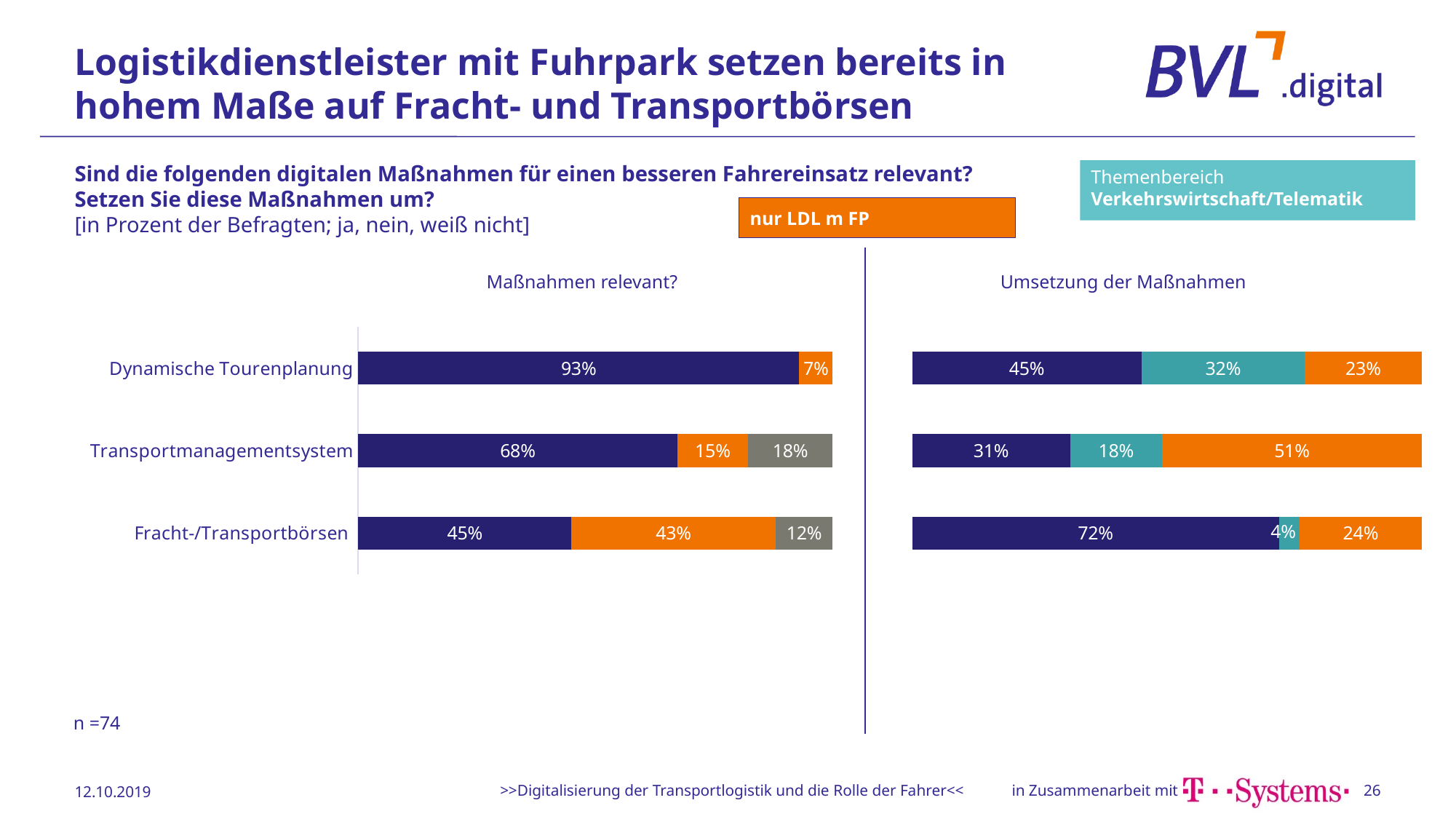
In the 'Maßnahmen relevant?' chart, which category has the highest value in the first (dark blue) segment? Dynamische Tourenplanung What type of chart is the 'Maßnahmen relevant?' chart? Stacked bar chart In the 'Umsetzung der Maßnahmen' chart, what is the total of the three segments for Dynamische Tourenplanung? 100% In the 'Umsetzung der Maßnahmen' chart, what is the difference between the orange segment for Transportmanagementsystem and the orange segment for Dynamische Tourenplanung? 28% In the 'Umsetzung der Maßnahmen' chart, what is the value of the teal segment for Transportmanagementsystem? 18% What is the sample size (n) stated on the slide? n =74 How many categories are shown in the 'Umsetzung der Maßnahmen' chart? 3 In the 'Maßnahmen relevant?' chart, what is the value of the first (dark blue) segment for Dynamische Tourenplanung? 93% In the 'Umsetzung der Maßnahmen' chart, what is the value of the first (dark blue) segment for Fracht-/Transportbörsen? 72% In the 'Maßnahmen relevant?' chart, which is larger: the grey segment for Transportmanagementsystem or the grey segment for Fracht-/Transportbörsen? Transportmanagementsystem In the 'Maßnahmen relevant?' chart, what is the value of the orange segment for Fracht-/Transportbörsen? 43% In the 'Umsetzung der Maßnahmen' chart, which category has the lowest value in the first (dark blue) segment? Transportmanagementsystem